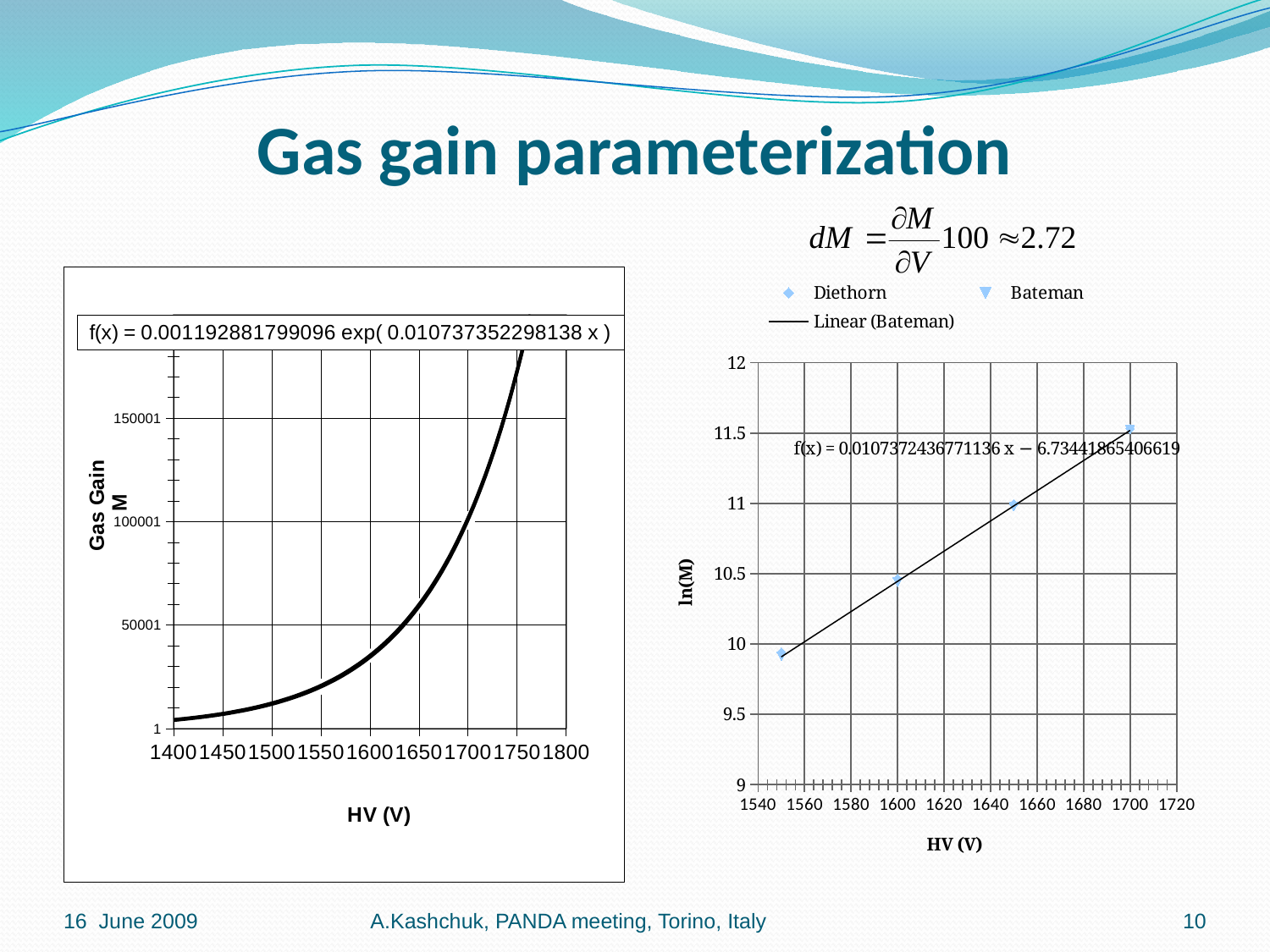
In the left chart (Gas Gain M vs HV), is the gas gain at HV = 1600 V greater or less than 50001? less What is the label of the x axis of the left chart (Gas Gain M)? HV (V) In the right chart (ln(M) vs HV), at which HV value is ln(M) highest? 1700 How many data points are plotted in the right chart (ln(M) vs HV)? 8 How many entries does the legend of the right chart (ln(M) vs HV) list? 3 In the left chart (Gas Gain M vs HV), does the gas gain rise or fall as HV increases? rises In the right chart (ln(M) vs HV), at which HV value is ln(M) lowest? 1550 What kind of chart is the right chart with the y axis labelled ln(M)? scatter chart In the right chart (ln(M) vs HV), is the value of ln(M) at HV = 1700 greater or less than 11? greater What kind of chart is the left chart with the y axis labelled Gas Gain M? line chart In the left chart (Gas Gain M vs HV), is the gas gain at HV = 1500 V greater or less than 50001? less